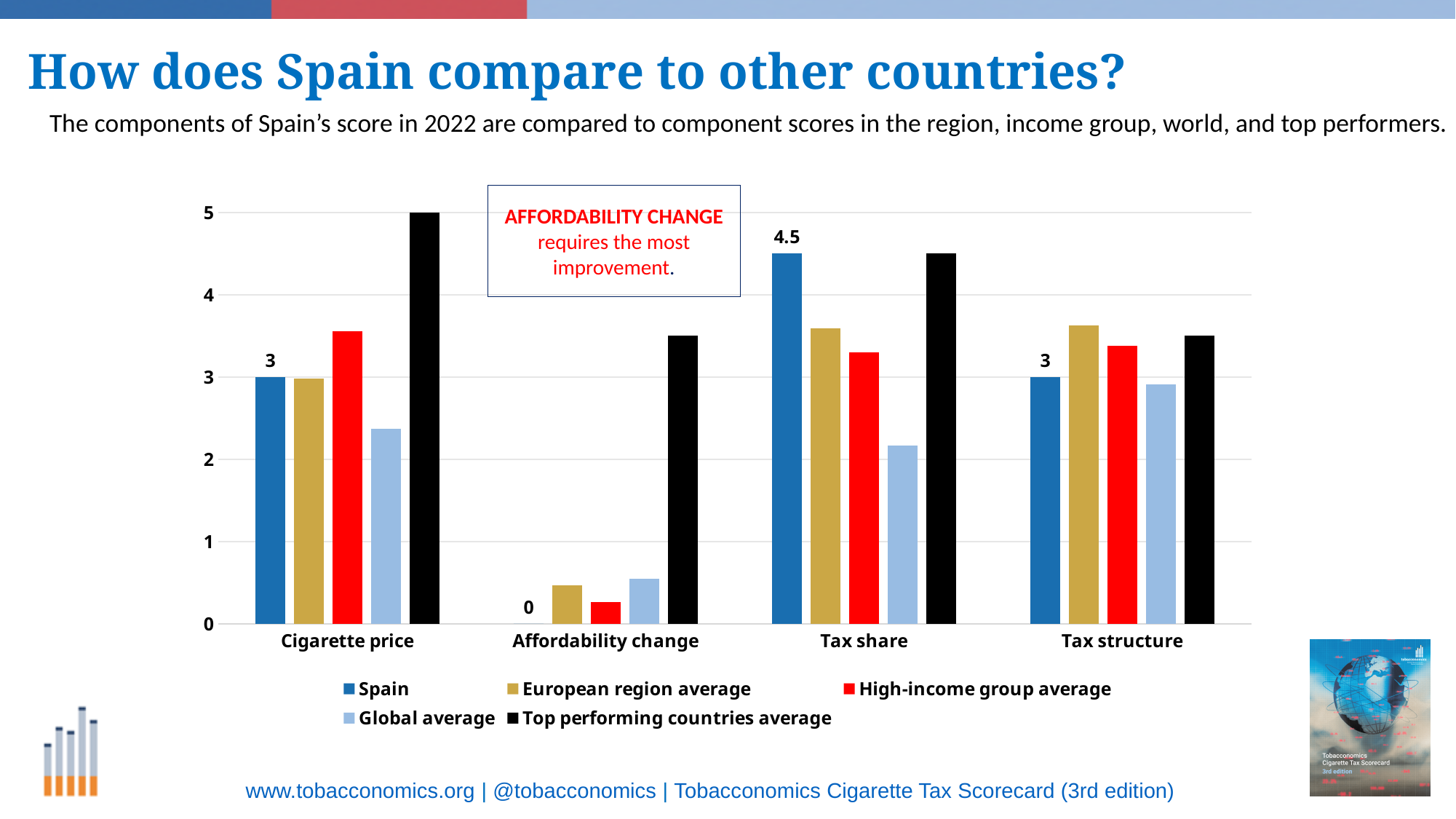
In which component does Spain have its highest score? Tax share How many components are shown on the x axis? 4 Is the Top performing countries average for Affordability change greater or less than 3? greater What is the Top performing countries average for Cigarette price? 5 In which component does Spain have its lowest score? Affordability change What is Spain's score for Tax share? 4.5 How many series does the legend list? 5 What is Spain's score for Affordability change? 0 What is the difference between Spain's Tax share score and its Cigarette price score? 1.5 What is Spain's score for Cigarette price? 3 Which is larger for Spain: the Tax share score or the Tax structure score? Tax share Is the Global average for Cigarette price greater or less than 3? less